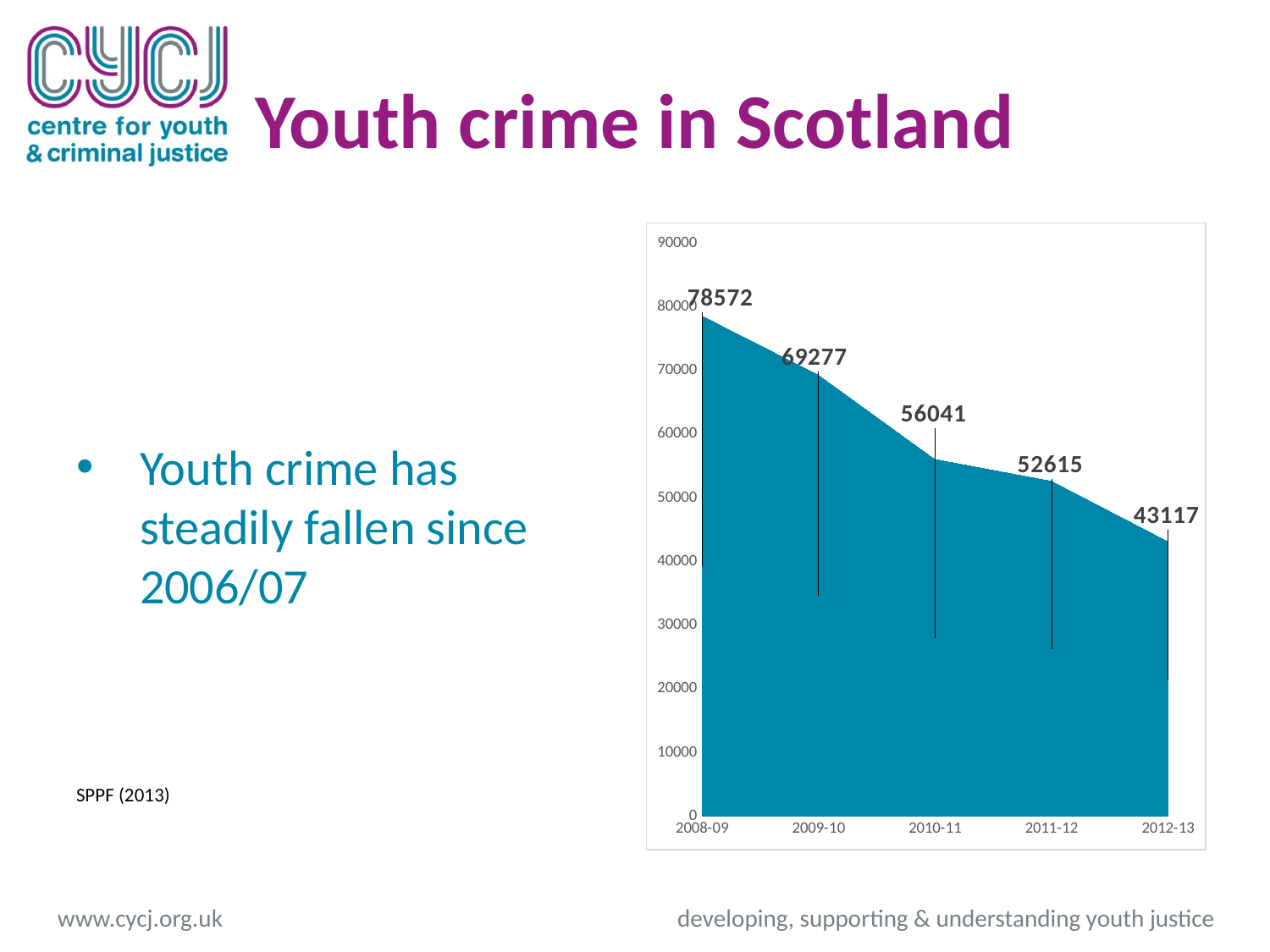
Which year has the lowest value? 2012-13 Which is larger, the value for 2009-10 or the value for 2011-12? 2009-10 Is the value for 2010-11 greater or less than 60000? less What is the value for 2008-09? 78572 Which year has the highest value? 2008-09 How many years are plotted on the chart? 5 What is the value for 2010-11? 56041 What is the value for 2012-13? 43117 What kind of chart is shown on the slide? area chart What is the difference between the values for 2011-12 and 2012-13? 9498 Do the values rise or fall from 2008-09 to 2012-13? fall What is the difference between the values for 2008-09 and 2009-10? 9295